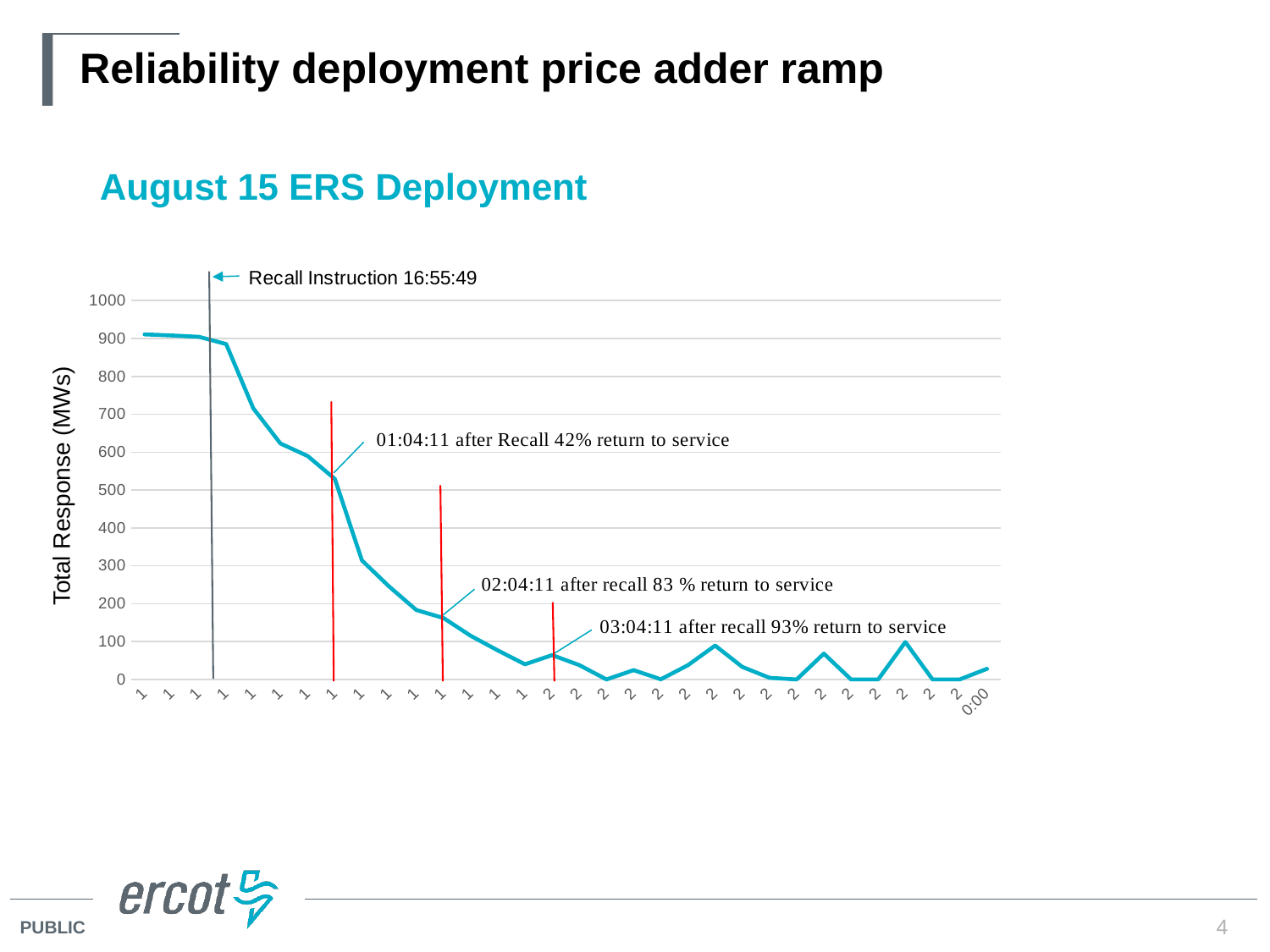
Is the Total Response at 01:04:11 after Recall greater or less than 600? less What is the title of the chart? August 15 ERS Deployment Which is larger, the Total Response at 01:04:11 after Recall or at 02:04:11 after recall? 01:04:11 after Recall What is the label on the vertical axis of the chart? Total Response (MWs) Is the Total Response at 02:04:11 after recall greater or less than 200? less What percentage return to service is annotated at 01:04:11 after Recall? 42% What percentage return to service is annotated at 03:04:11 after recall? 93% Overall, does the Total Response rise or fall along the x axis? fall Is the Total Response at 03:04:11 after recall greater or less than 100? less What kind of chart is shown on the slide? line chart